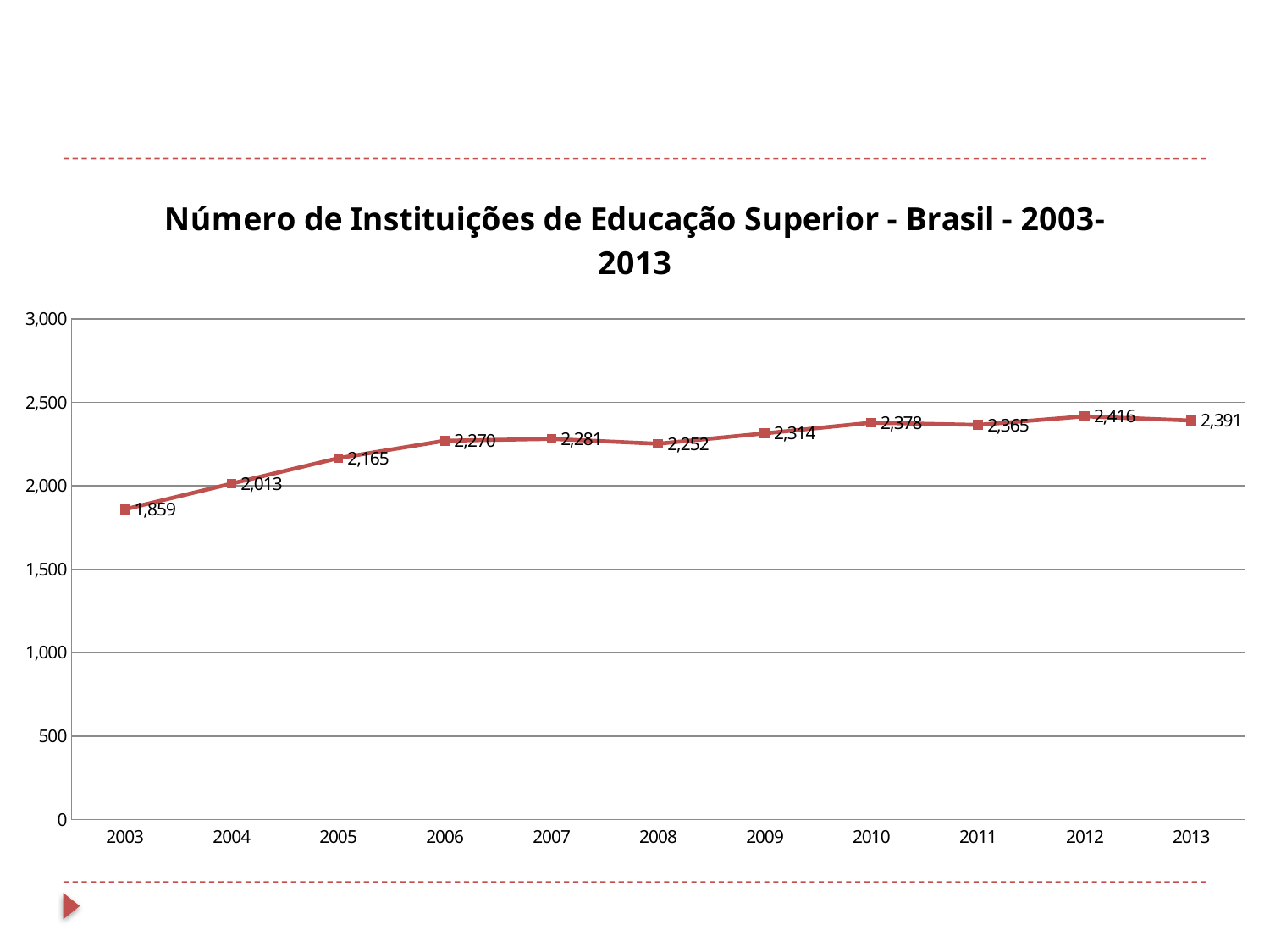
What is the number of institutions in 2008? 2,252 Which year has the highest number of institutions? 2012 What kind of chart is shown on the slide? line chart Does the number of institutions generally rise or fall from 2003 to 2013? rise What is the number of institutions in 2003? 1,859 What is the difference between the values for 2012 and 2011? 51 Which year has a larger value, 2007 or 2008? 2007 Which year has the lowest number of institutions? 2003 How many years are plotted on the chart? 11 What is the difference between the values for 2013 and 2003? 532 What is the number of institutions in 2013? 2,391 Is the value for 2004 greater or less than 2,500? less